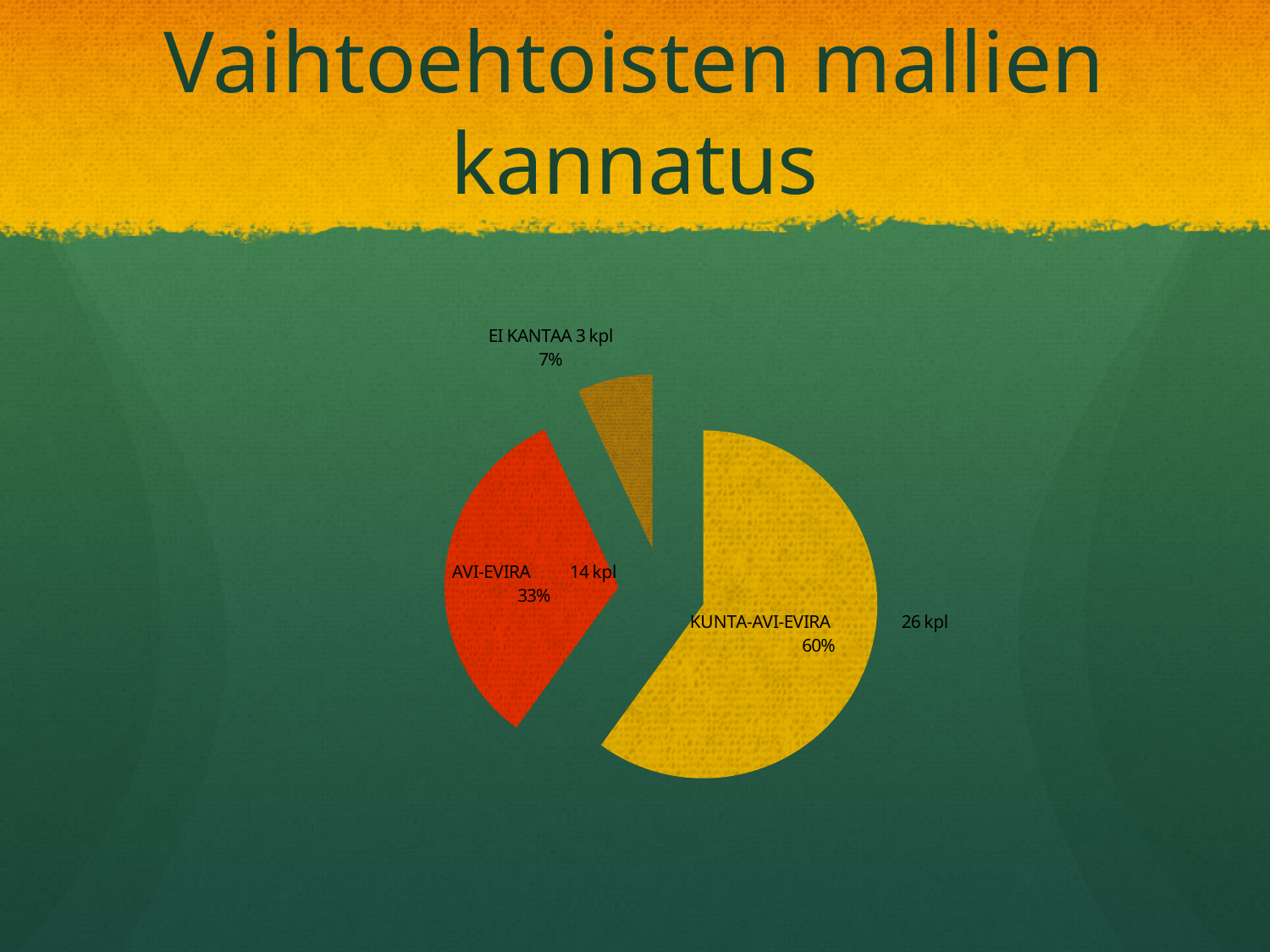
What kind of chart is shown on the slide? pie chart What is the difference in kpl between KUNTA-AVI-EVIRA and AVI-EVIRA? 12 kpl What share of the pie does EI KANTAA have? 7% What is the title of the slide containing the pie chart? Vaihtoehtoisten mallien kannatus How many kpl are shown for KUNTA-AVI-EVIRA? 26 kpl How many kpl are shown for AVI-EVIRA? 14 kpl How many slices does the pie chart have? 3 Which category has the smallest slice of the pie? EI KANTAA What share of the pie does AVI-EVIRA have? 33% What share of the pie does KUNTA-AVI-EVIRA have? 60% How many kpl are shown for EI KANTAA? 3 kpl Which category has the largest slice of the pie? KUNTA-AVI-EVIRA